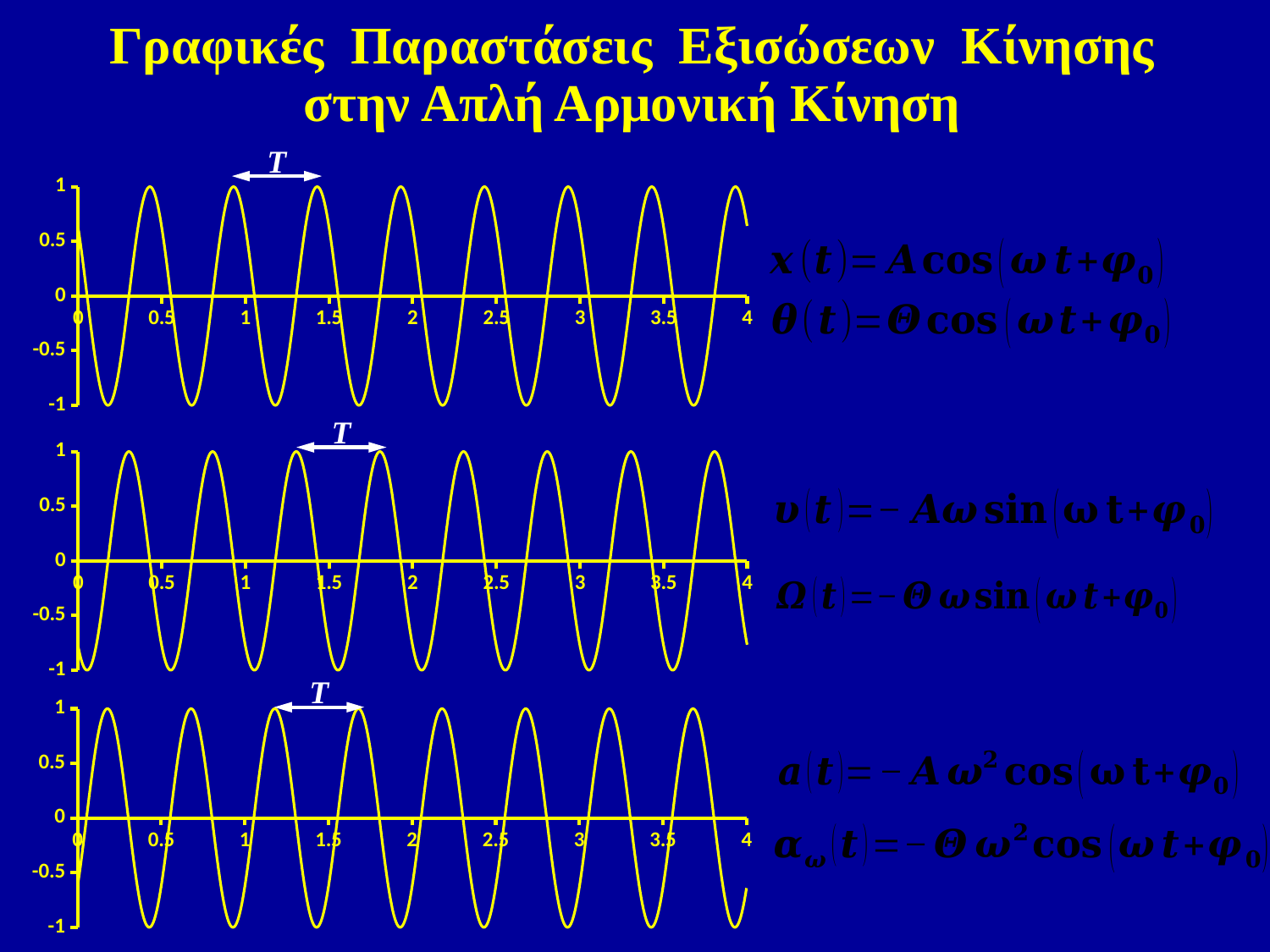
How many charts are shown on the slide? 3 In the middle chart, is the value of the curve at x = 0 greater or less than -0.5? less What letter labels the double-headed arrow above each chart marking one period? T What kind of chart is the top chart on the slide? line chart In the middle chart, what is the minimum value reached by the curve? -1 How many lines are plotted in the middle chart? 1 In the bottom chart, what is the maximum value reached by the curve? 1 What is the largest value shown on the x axis of the top chart? 4 In the top chart, what is the maximum value reached by the curve? 1 In the bottom chart, is the value of the curve at x = 0 greater or less than 0.5? less